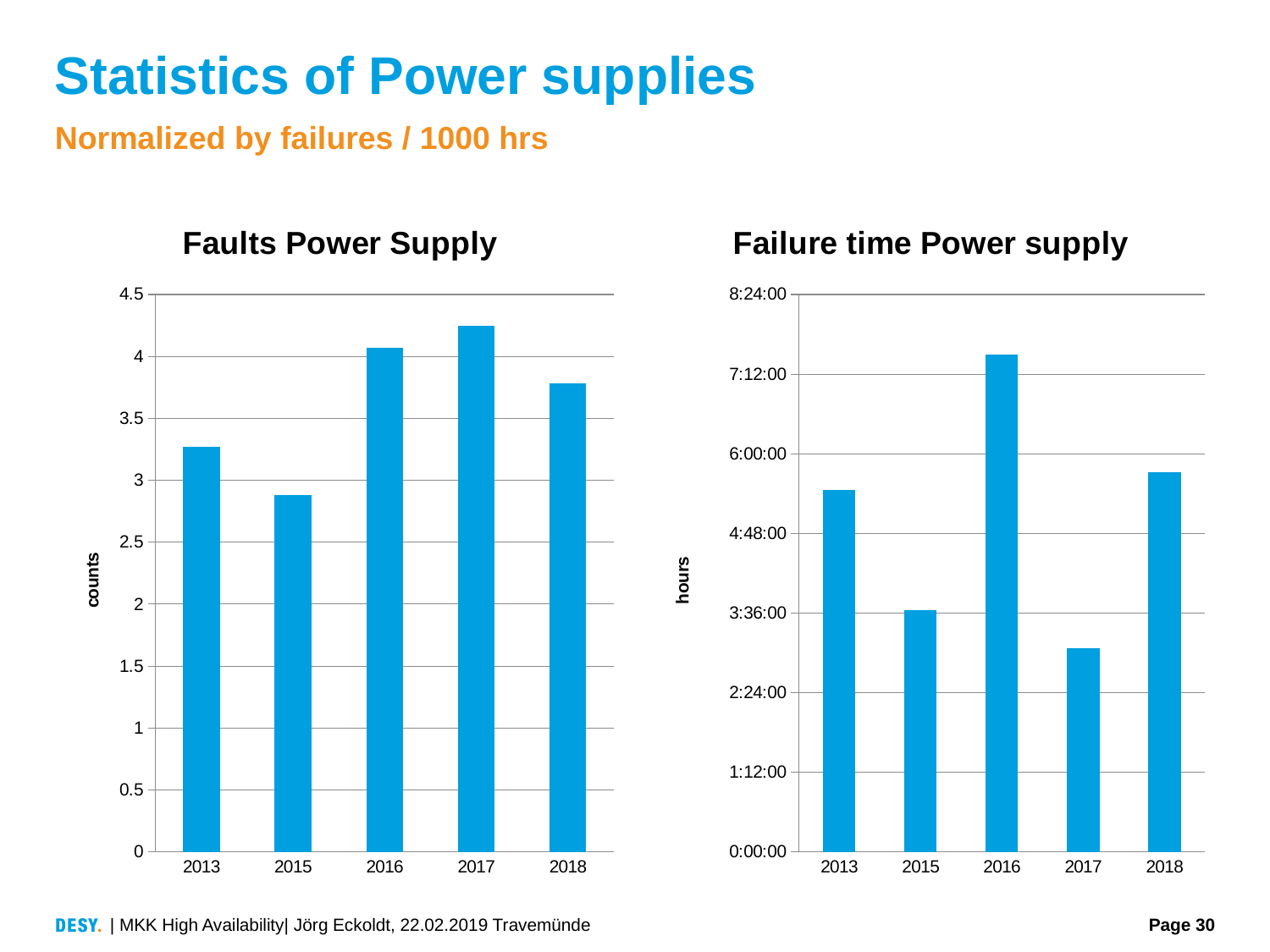
In the Failure time Power supply chart, is the value for 2016 greater or less than 7:12:00? greater In the Faults Power Supply chart, which is larger, the value for 2013 or the value for 2018? 2018 In the Failure time Power supply chart, which is larger, the value for 2013 or the value for 2015? 2013 In the Faults Power Supply chart, which year has the lowest value? 2015 In the Faults Power Supply chart, is the value for 2015 greater or less than 3? less In the Faults Power Supply chart, what is the label on the y axis? counts In the Faults Power Supply chart, which year has the highest value? 2017 In the Failure time Power supply chart, which year has the highest value? 2016 In the Failure time Power supply chart, which year has the lowest value? 2017 In the Faults Power Supply chart, what kind of chart is used? bar chart In the Faults Power Supply chart, is the value for 2016 greater or less than 4? greater In the Faults Power Supply chart, how many years are shown on the x axis? 5